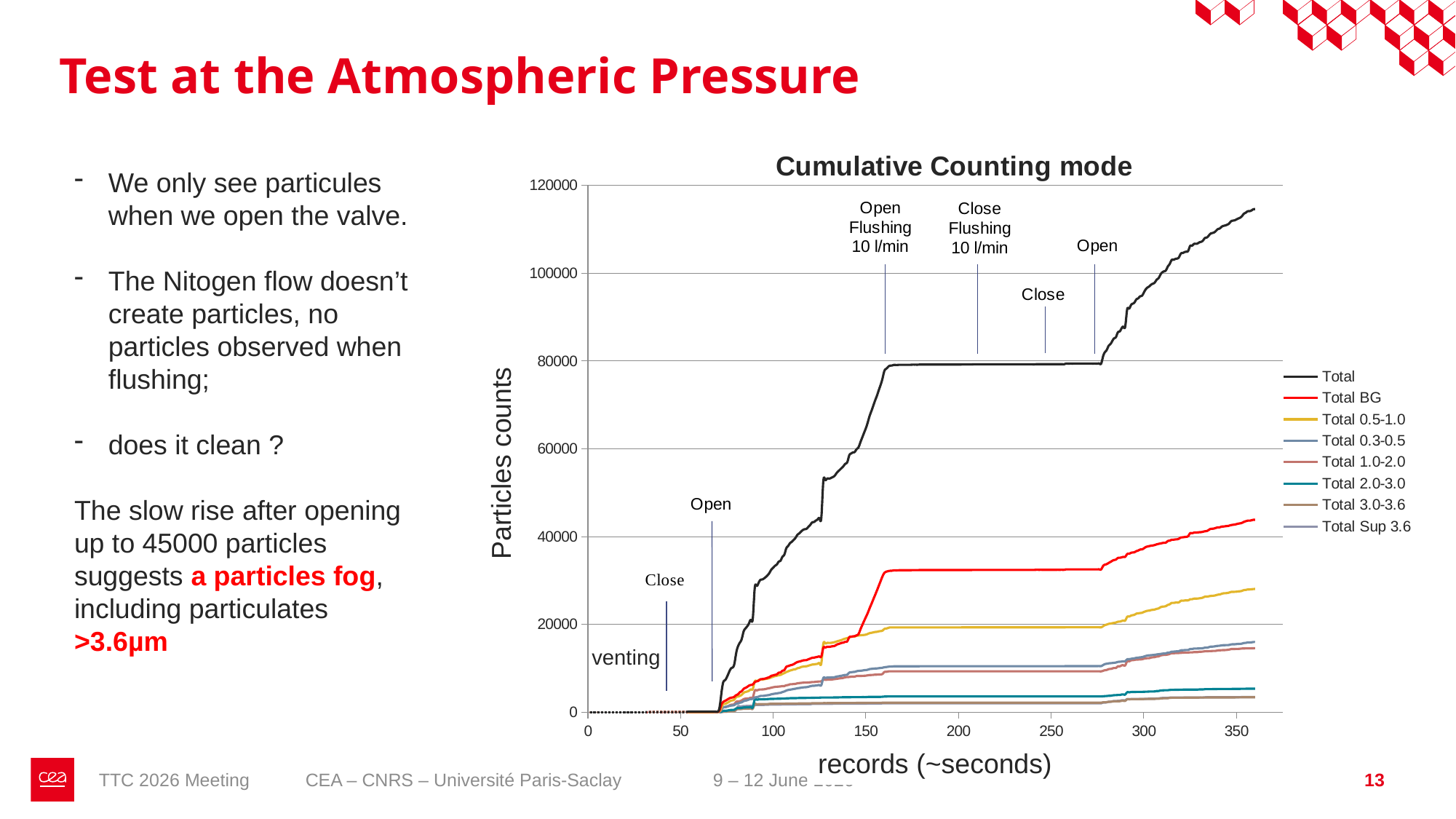
Which series reaches the highest value at the right end of the chart? Total At record 350, which series has the larger value, Total BG or Total 0.5-1.0? Total BG Do the values of the Total series rise or fall along the x axis? rise Is the value of the Total BG series at record 350 greater or less than 60000? less How many series does the legend of the chart list? 8 What is the value of the Total series at record 50? 0 Is the value of the Total series at record 150 greater or less than 40000? greater What kind of chart is shown on the slide? line chart What is the title of the chart? Cumulative Counting mode What is the label of the y axis of the chart? Particles counts Is the value of the Total 0.5-1.0 series at record 350 greater or less than 20000? greater